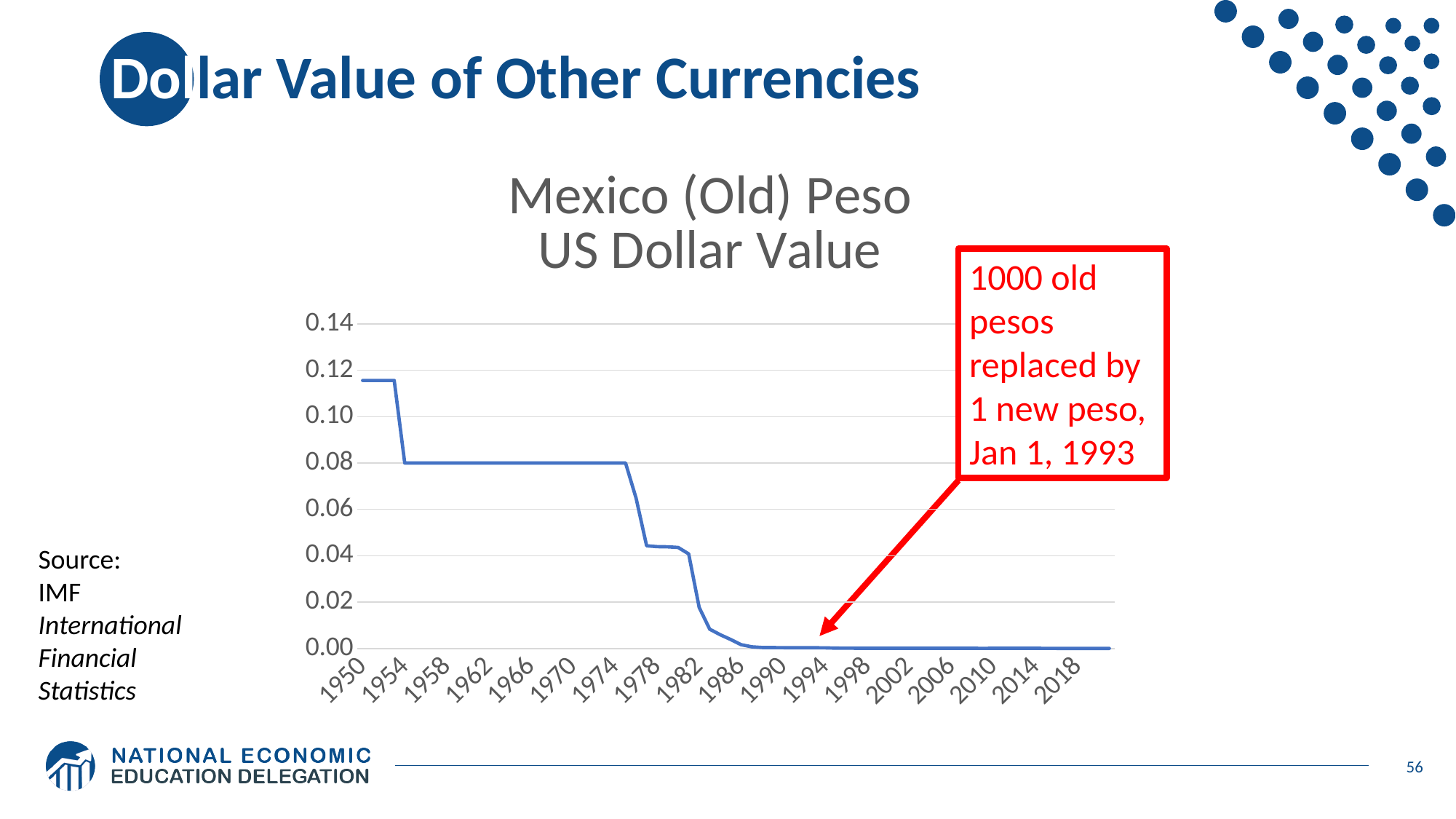
What kind of chart is shown on the slide? line chart Is the value for 1978 greater or less than 0.06? less What is the title of the chart? Mexico (Old) Peso US Dollar Value How many year labels are shown on the x axis? 18 Which year on the x axis has the highest value? 1950 Do the values rise or fall along the x axis from 1950 to 2018? fall Is the value for 1966 greater or less than 0.10? less Which is larger, the value for 1954 or the value for 1986? 1954 What does the red annotation box on the chart say? 1000 old pesos replaced by 1 new peso, Jan 1, 1993 Is the value for 1970 greater or less than 0.06? greater